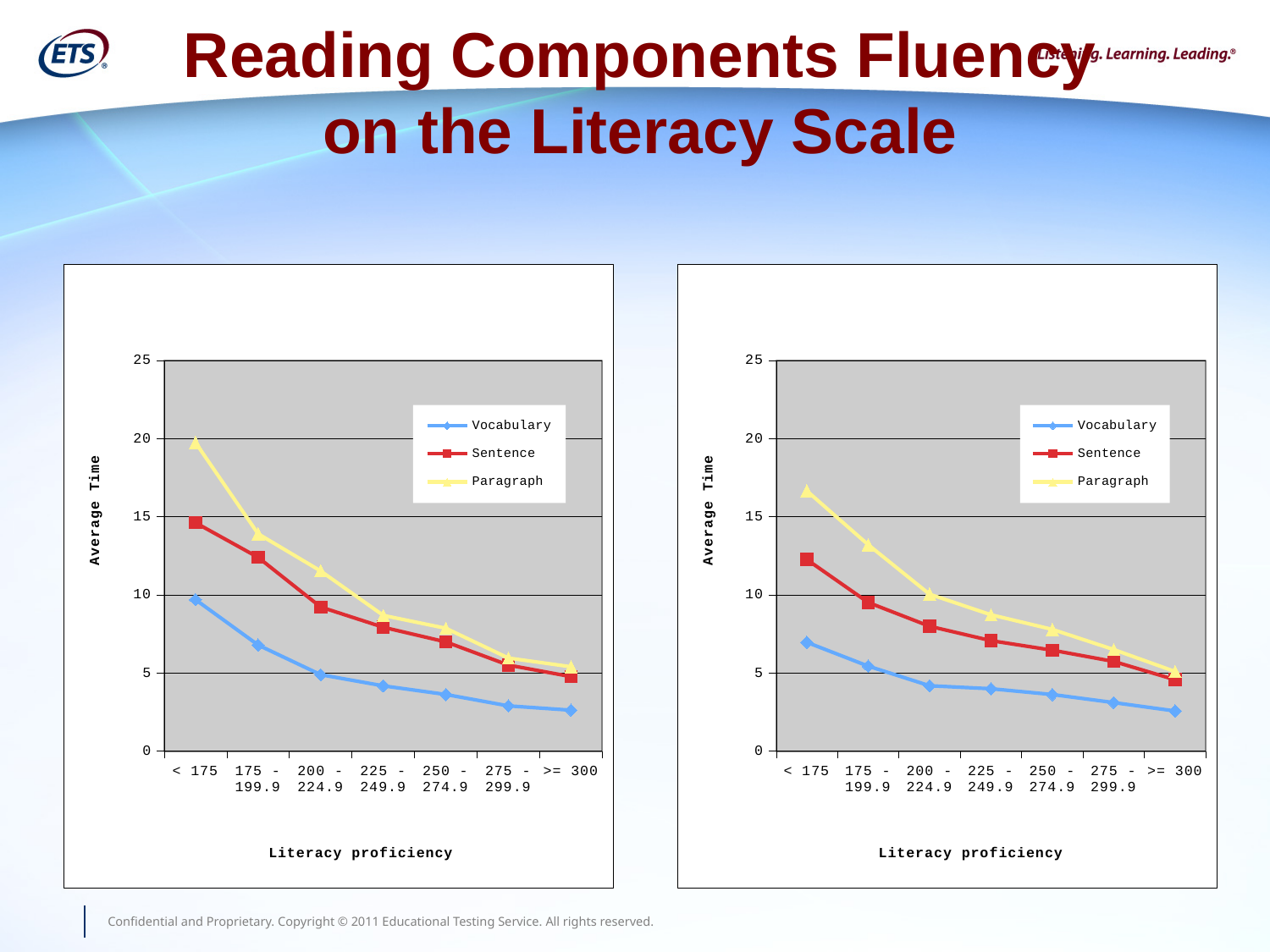
How many literacy proficiency categories are shown on the x axis of the left chart? 7 How many series does the legend of the right chart list? 3 In the left chart, is the Vocabulary value for >= 300 greater or less than 5? less In the right chart, is the Sentence value for < 175 greater or less than 10? greater In the right chart, do the Vocabulary values rise or fall along the x axis? fall In the left chart, which series has the highest value at < 175? Paragraph In the right chart, is the Vocabulary value for < 175 greater or less than 10? less What is the y-axis label of the right chart? Average Time In the right chart, which literacy proficiency category has the lowest Vocabulary value? >= 300 In the left chart, do the Paragraph values rise or fall as literacy proficiency increases? fall What kind of chart is the left chart? line chart